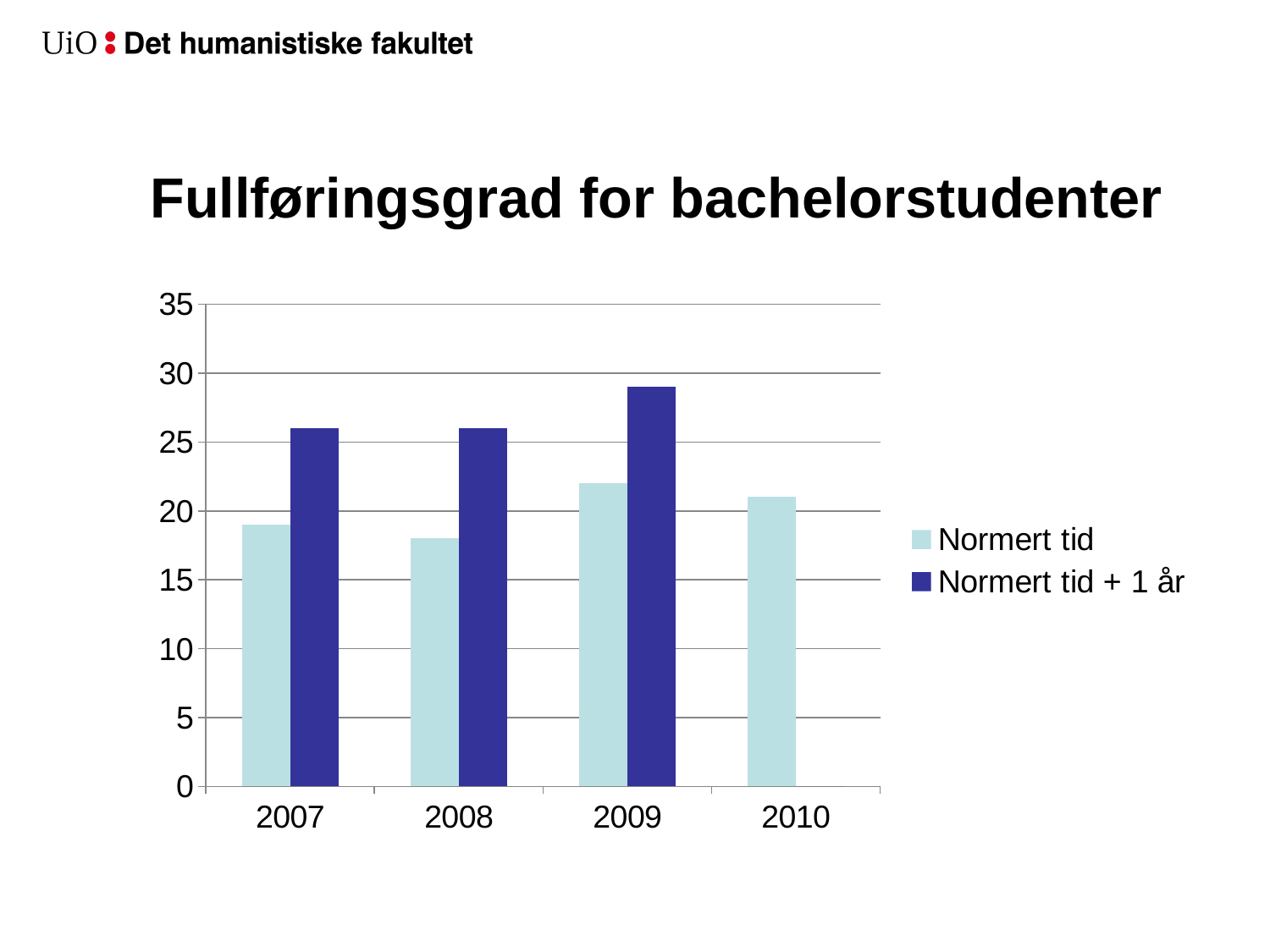
Is the value for Normert tid + 1 år in 2009 greater or less than 25? greater Which is larger: Normert tid in 2009 or Normert tid in 2008? 2009 What kind of chart is shown on the slide? bar chart Is the value for Normert tid in 2008 greater or less than 20? less Which is larger: Normert tid + 1 år in 2009 or Normert tid + 1 år in 2007? 2009 What is the title of the chart? Fullføringsgrad for bachelorstudenter Is the value for Normert tid in 2009 greater or less than 20? greater How many years are shown on the x axis? 4 How many series does the legend list? 2 Which year has no bar for Normert tid + 1 år? 2010 Which year has the highest value for Normert tid + 1 år? 2009